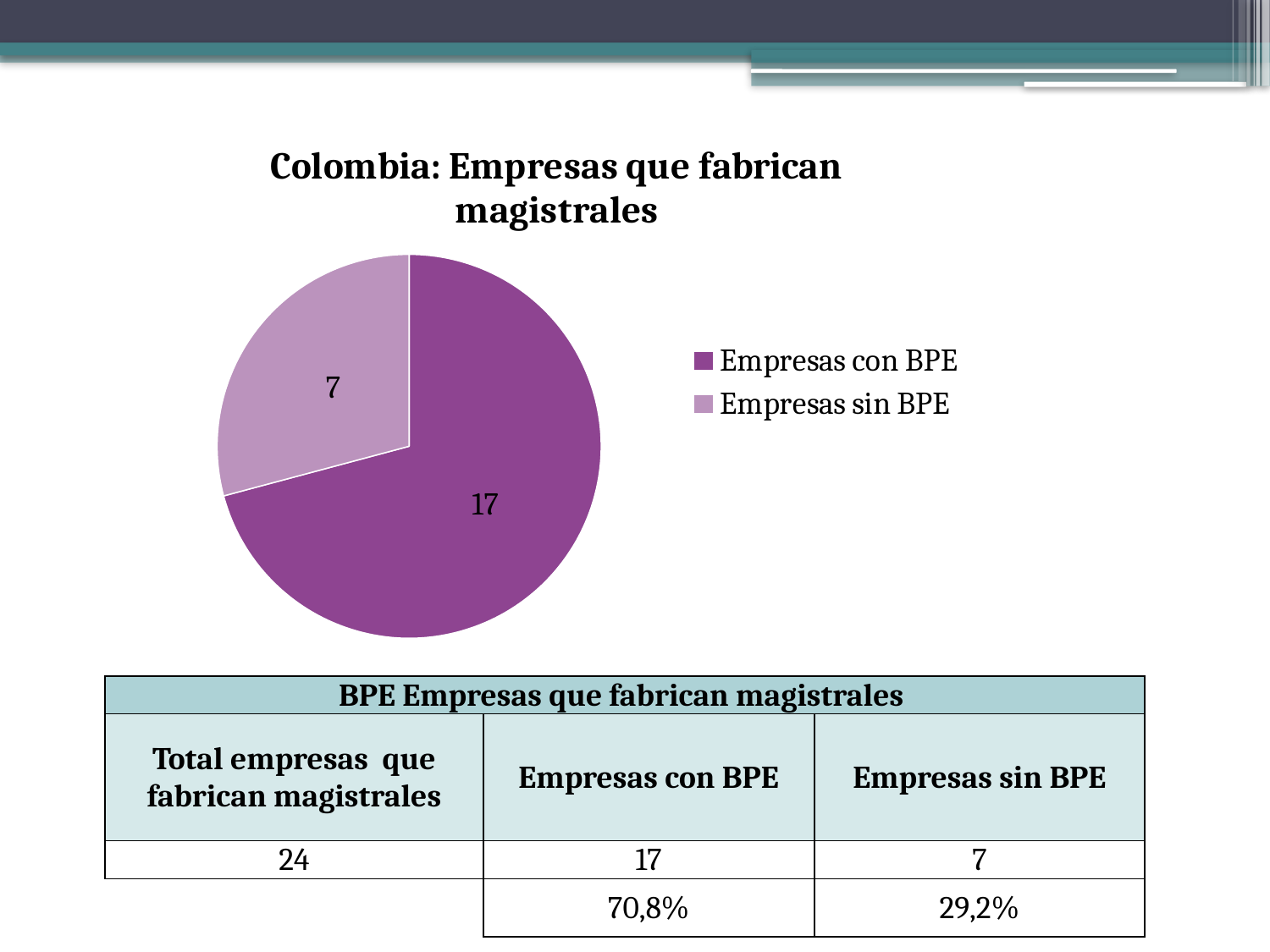
What is the total of all slices in the pie chart? 24 How many slices does the pie chart have? 2 What is the value for Empresas sin BPE in the pie chart? 7 Which slice of the pie chart is the largest? Empresas con BPE What is the title of the pie chart? Colombia: Empresas que fabrican magistrales Which slice of the pie chart is the smallest? Empresas sin BPE What share of the pie does Empresas con BPE represent? 70,8% Which is larger, Empresas con BPE or Empresas sin BPE? Empresas con BPE What kind of chart is shown on the slide? Pie chart What is the difference between the values for Empresas con BPE and Empresas sin BPE? 10 How many entries does the legend of the pie chart list? 2 What is the value for Empresas con BPE in the pie chart? 17